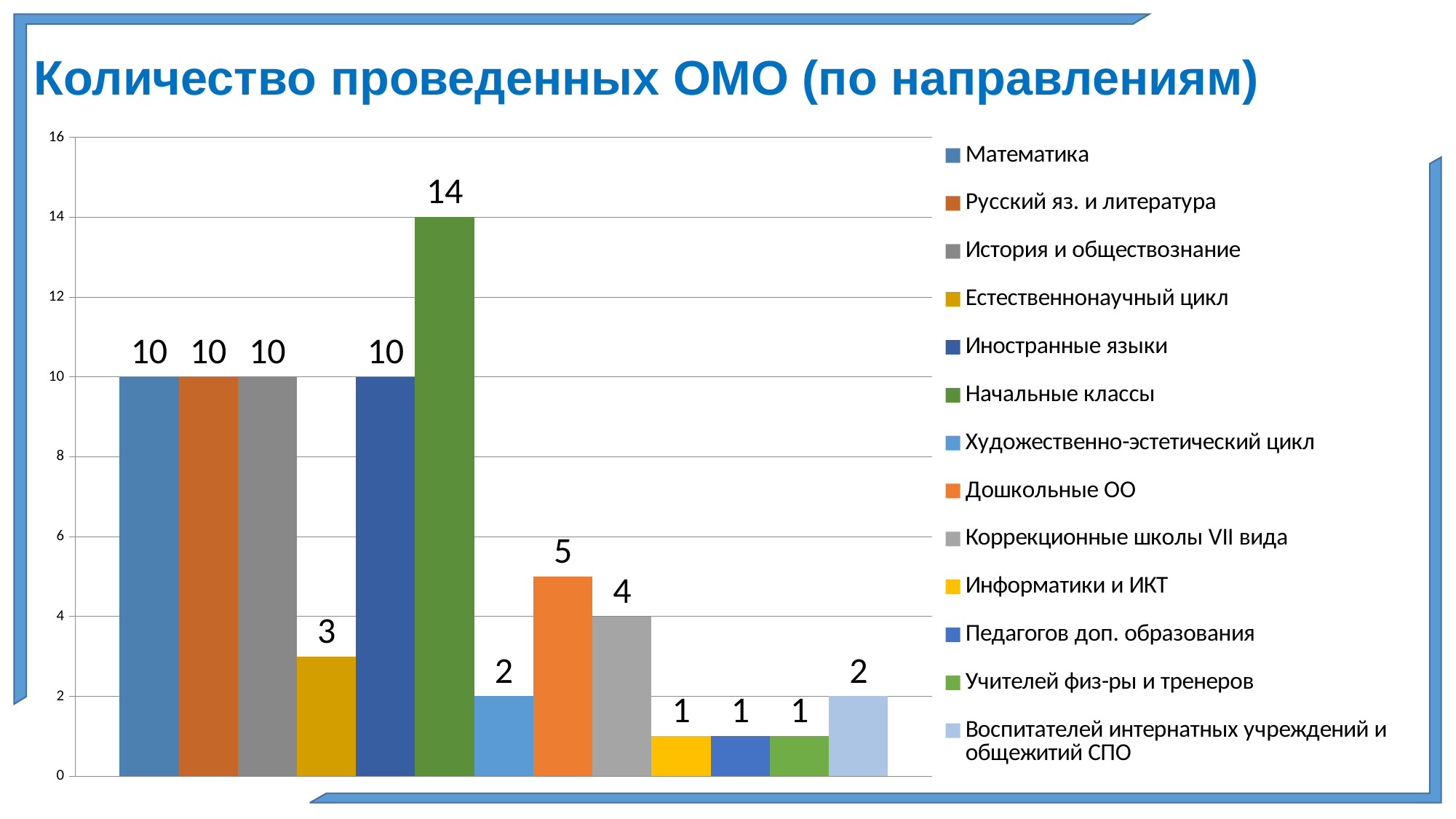
Is the value for Иностранные языки greater or less than 8? greater What kind of chart is shown on the slide? bar chart How many bars are plotted in the chart? 13 How many entries does the legend list? 13 What is the value for Воспитателей интернатных учреждений и общежитий СПО? 2 What is the value for Дошкольные ОО? 5 What is the difference between the values for Начальные классы and Математика? 4 What is the value for Коррекционные школы VII вида? 4 Which category has the highest value? Начальные классы What is the value for Начальные классы? 14 What is the value for Естественнонаучный цикл? 3 Which is larger, the value for Дошкольные ОО or the value for Коррекционные школы VII вида? Дошкольные ОО